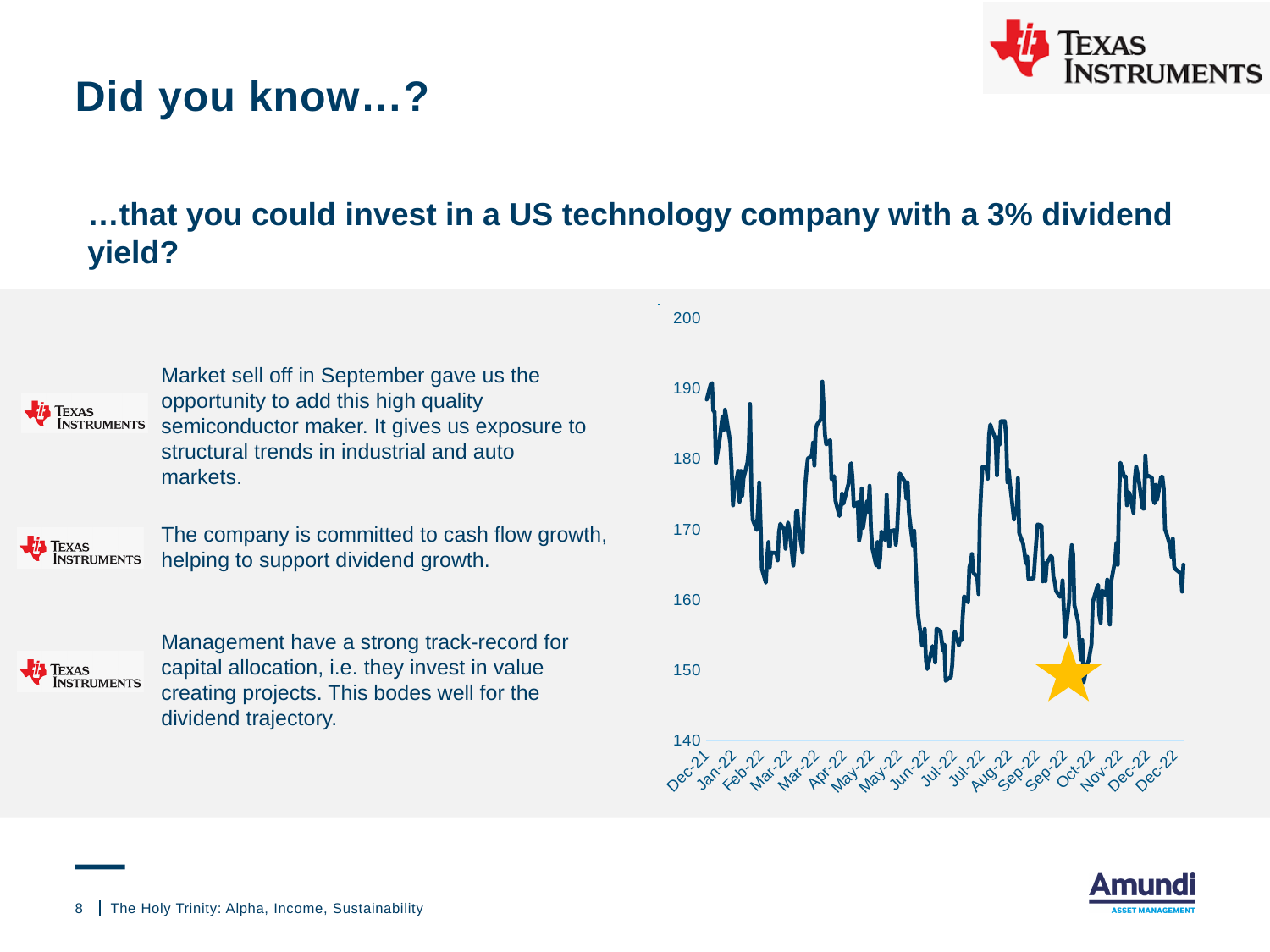
Do the values generally rise or fall from Jul-22 to Aug-22? rise Is the value at the point marked with the star (around Sep/Oct-22) greater or less than 160? less Is the value at the end of the chart (Dec-22) greater or less than 160? greater What symbol marks the low point of the line around Sep/Oct-22? a yellow star Is the lowest point of the line around Jul-22 greater or less than 160? less Do the values generally rise or fall from Dec-21 to Jul-22? fall Is the value at Dec-21 higher or lower than the value at Dec-22? higher What are the lowest and highest values shown on the y axis? 140 and 200 What kind of chart is shown on the slide? line chart